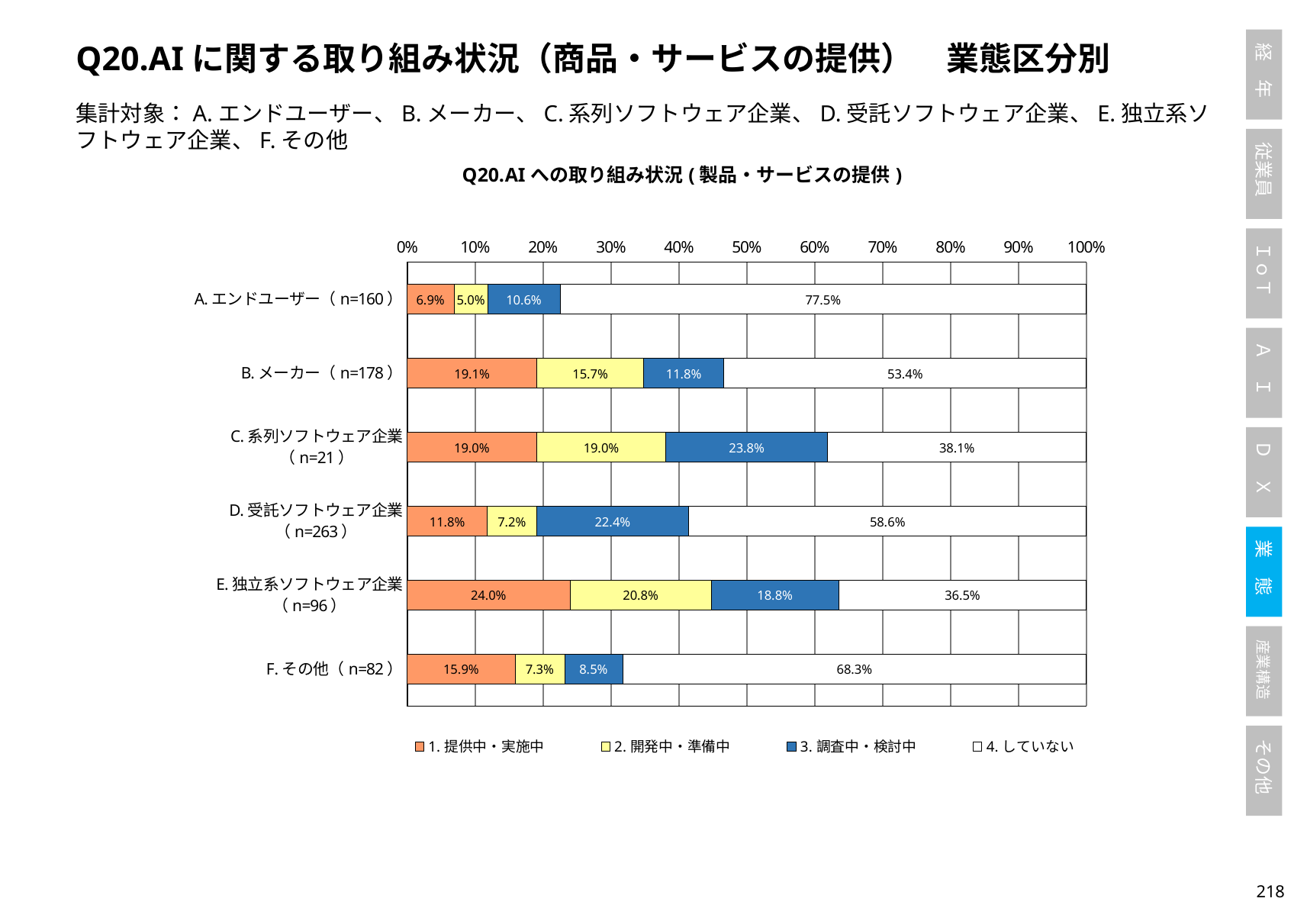
Which is larger: the 「3. 調査中・検討中」 value for C. 系列ソフトウェア企業 or for E. 独立系ソフトウェア企業? C. 系列ソフトウェア企業 What is the value of 「3. 調査中・検討中」 for D. 受託ソフトウェア企業? 22.4% What is the value of 「1. 提供中・実施中」 for E. 独立系ソフトウェア企業? 24.0% What is the value of 「2. 開発中・準備中」 for B. メーカー? 15.7% What is the sample size (n) shown for D. 受託ソフトウェア企業? 263 What is the value of 「4. していない」 for A. エンドユーザー? 77.5% How many categories (business types) are plotted on the chart? 6 How many series does the legend list? 4 Which category has the highest value for 「1. 提供中・実施中」? E. 独立系ソフトウェア企業 What is the difference between the 「4. していない」 values for A. エンドユーザー and F. その他? 9.2% What type of chart is shown on the slide? Stacked bar chart Which category has the lowest value for 「4. していない」? E. 独立系ソフトウェア企業